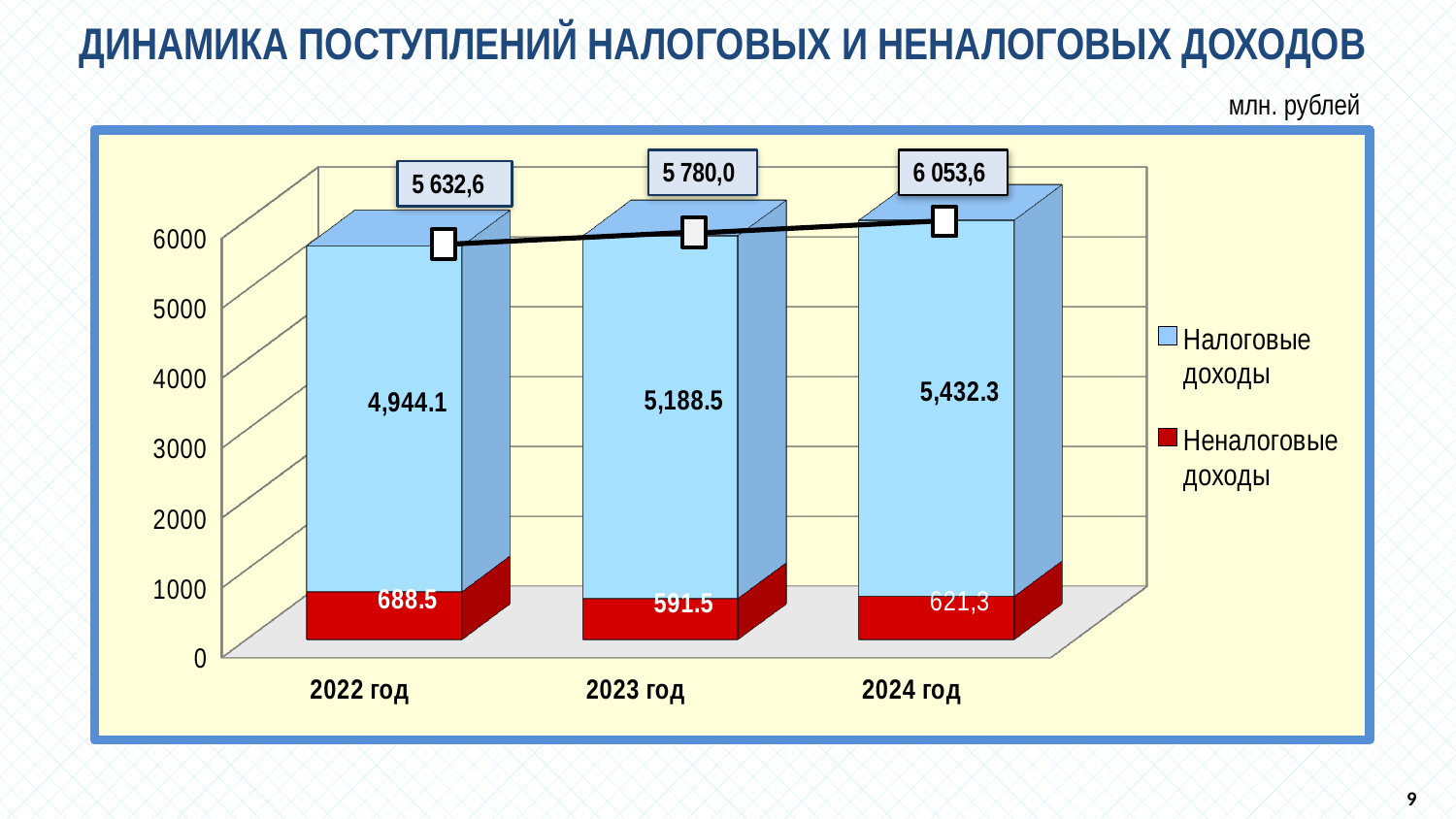
What is the value of Налоговые доходы for 2023 год? 5,188.5 What is the difference between Налоговые доходы in 2024 год and 2022 год? 488.2 How many series does the legend list? 2 Which year has the lowest value of Неналоговые доходы? 2023 год Do the values of Налоговые доходы rise or fall from 2022 год to 2024 год? Rise How many years are shown on the x axis? 3 What is the value of Неналоговые доходы for 2022 год? 688.5 What total is labelled above the bar for 2024 год? 6 053,6 What kind of chart is shown on the slide? Stacked bar chart with a line Which is larger: Неналоговые доходы in 2022 год or in 2024 год? 2022 год What is the value of Неналоговые доходы for 2024 год? 621,3 Which year has the highest value of Налоговые доходы? 2024 год